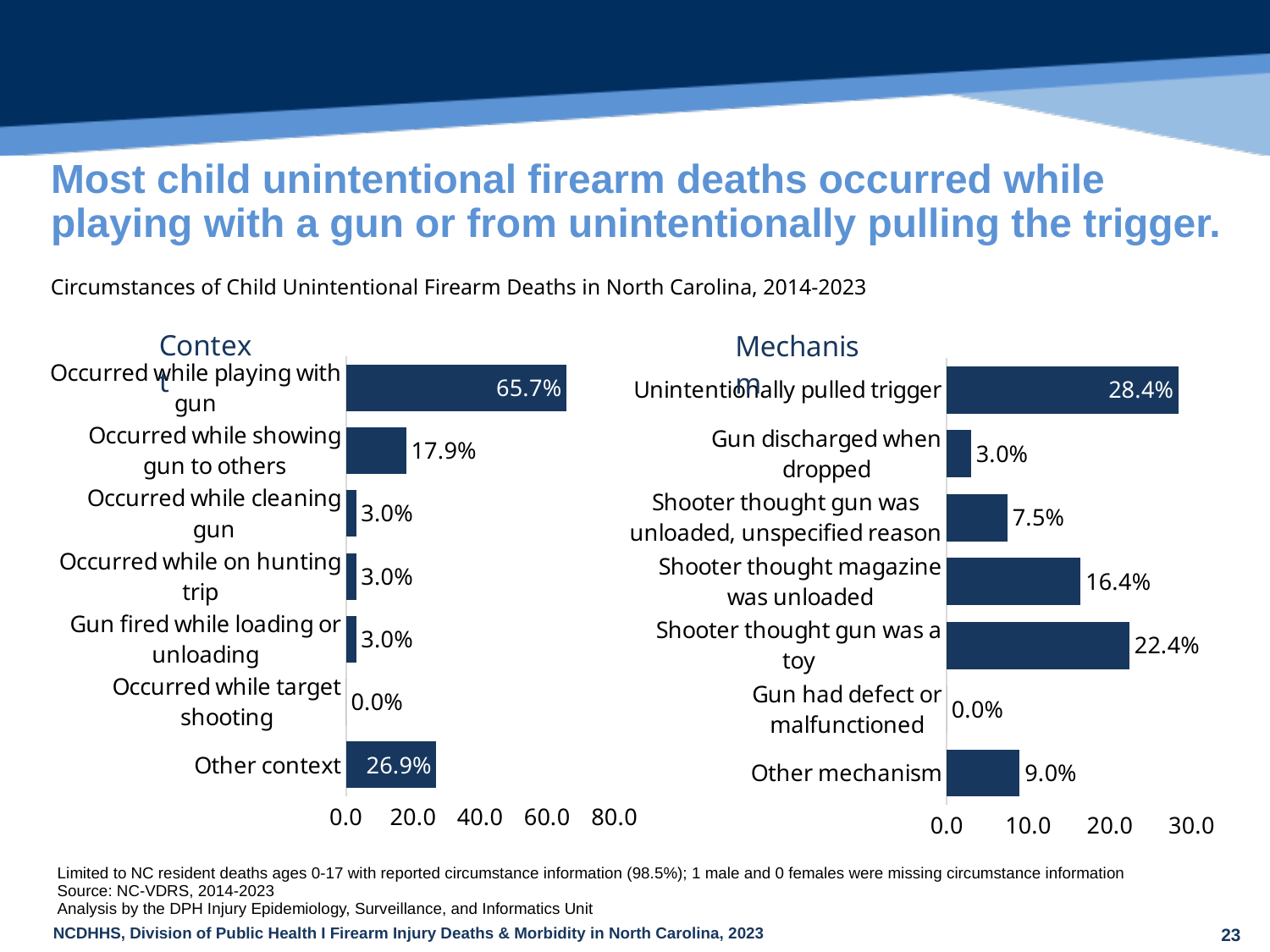
How many categories are shown in the Mechanism chart? 7 What type of chart is the Context chart? Bar chart In the Mechanism chart, what percentage is shown for 'Shooter thought gun was a toy'? 22.4% How many categories are shown in the Context chart? 7 In the Mechanism chart, which category has the highest value? Unintentionally pulled trigger In the Mechanism chart, which is larger: 'Shooter thought gun was unloaded, unspecified reason' or 'Other mechanism'? Other mechanism In the Context chart, what percentage of child unintentional firearm deaths occurred while playing with a gun? 65.7% In the Mechanism chart, which category has the lowest value? Gun had defect or malfunctioned In the Context chart, what is the difference between 'Occurred while playing with gun' and 'Other context'? 38.8% In the Context chart, which category has the highest value? Occurred while playing with gun In the Context chart, what value is shown for 'Occurred while target shooting'? 0.0% In the Mechanism chart, what is the difference between 'Unintentionally pulled trigger' and 'Shooter thought magazine was unloaded'? 12.0%